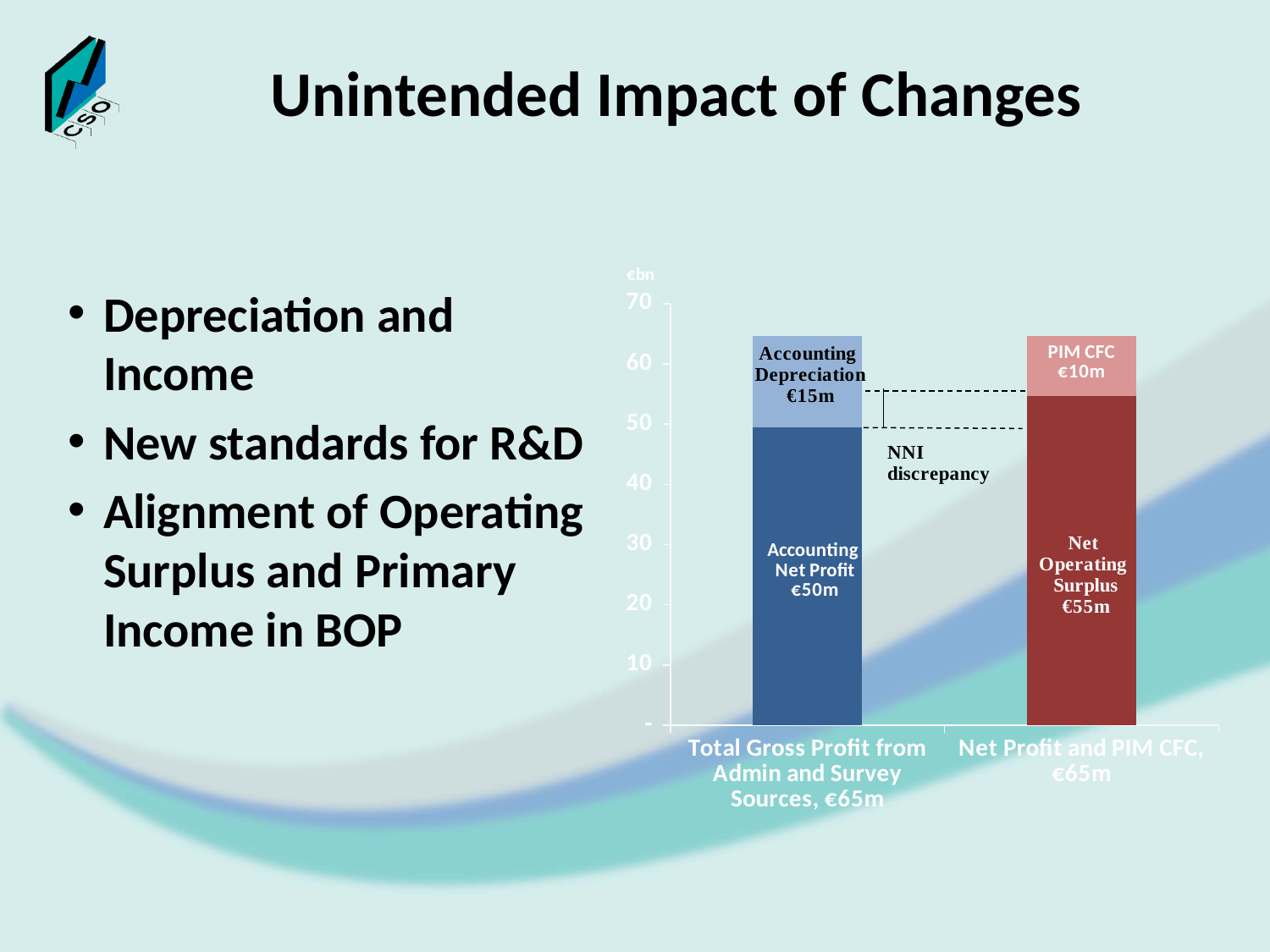
Which segment in the chart has the smallest value? PIM CFC What is the value of the PIM CFC segment? €10m What is the total of the 'Net Profit and PIM CFC' bar? €65m What is the difference between the Net Operating Surplus segment and the Accounting Net Profit segment? €5m What kind of chart is shown on the slide? stacked bar chart What is the value of the Accounting Net Profit segment? €50m Which is larger, the Accounting Depreciation segment or the PIM CFC segment? Accounting Depreciation What label is written between the two bars next to the dashed lines? NNI discrepancy How many bars are plotted in the chart? 2 What is the value of the Net Operating Surplus segment? €55m What is the value of the Accounting Depreciation segment? €15m What is the total of the 'Total Gross Profit from Admin and Survey Sources' bar? €65m